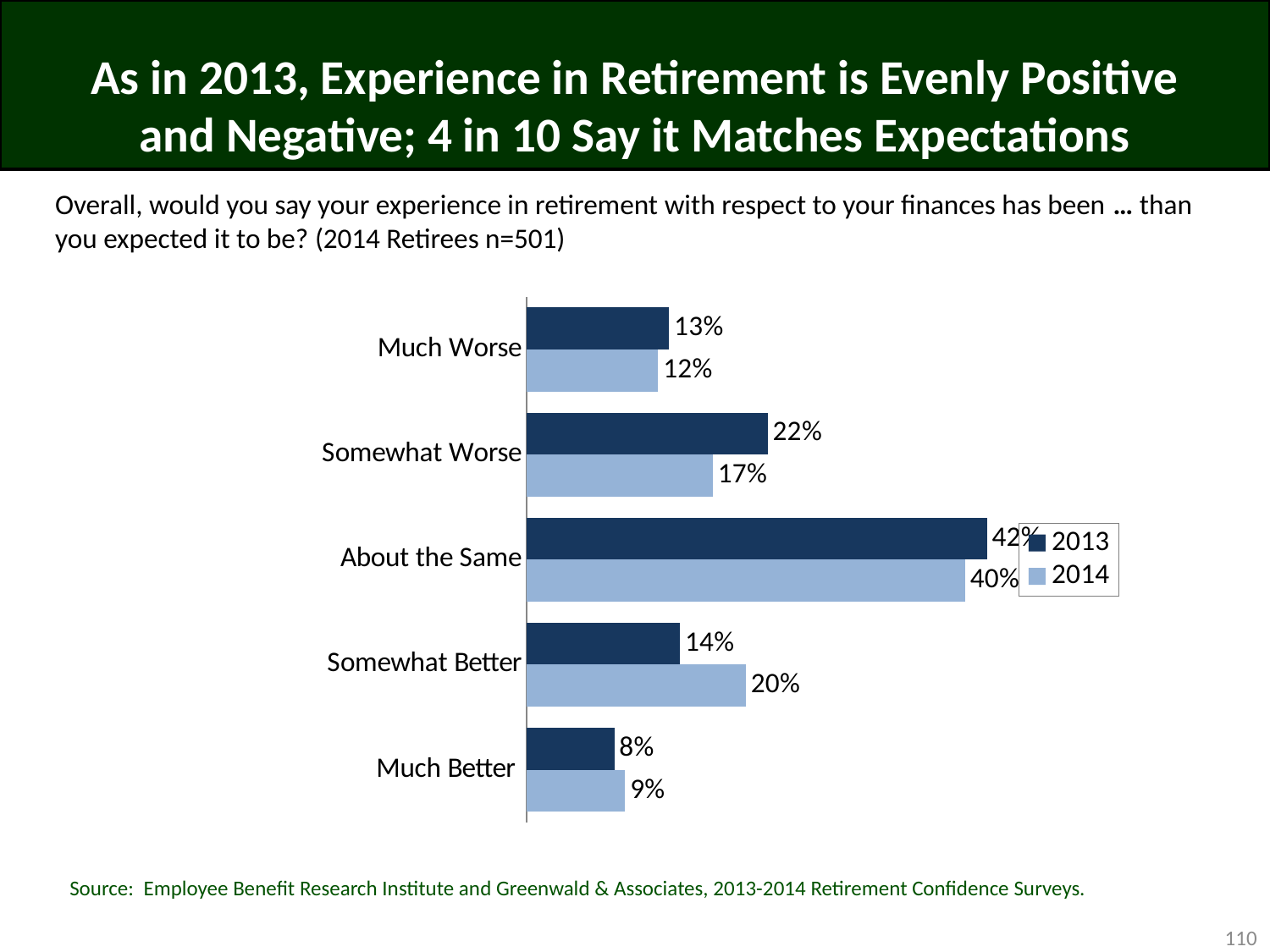
What is the 2013 value for Much Better? 8% What is the 2013 value for Somewhat Worse? 22% Which is larger for Much Worse, the 2013 value or the 2014 value? 2013 How many categories are shown on the chart? 5 How many series does the legend list? 2 What kind of chart is shown on the slide? Bar chart What is the 2014 value for About the Same? 40% What is the difference between the 2013 and 2014 values for Somewhat Better? 6% What is the difference between the 2013 and 2014 values for Somewhat Worse? 5% Which category has the highest 2013 value? About the Same What is the 2014 value for Somewhat Better? 20% Which category has the lowest 2014 value? Much Better